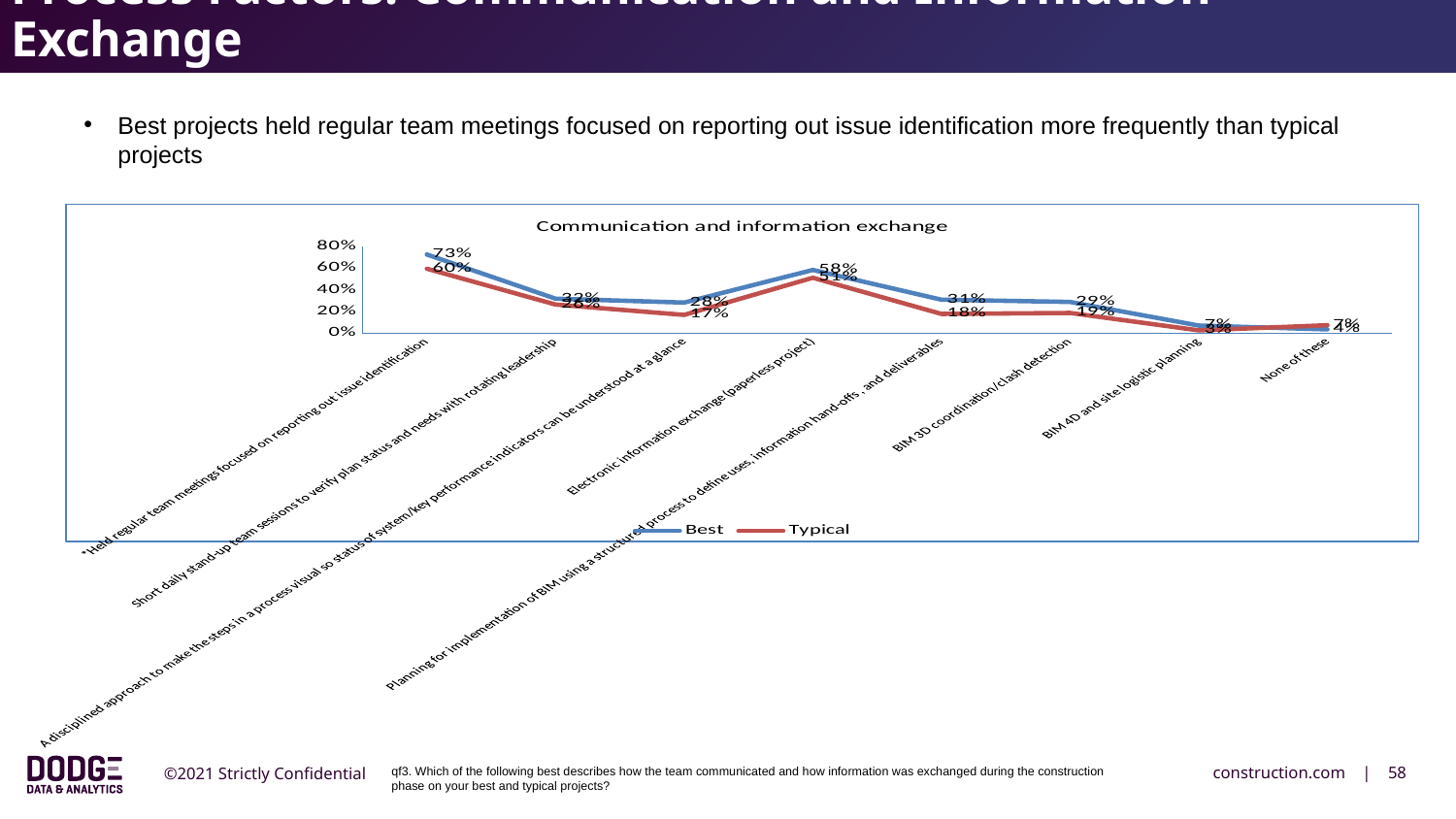
Which is larger for 'Electronic information exchange (paperless project)': the Best value or the Typical value? Best What type of chart is shown on the slide? Line chart Which category has the highest Best value? Held regular team meetings focused on reporting out issue identification What is the Best value for 'Electronic information exchange (paperless project)'? 58% What is the Typical value for 'BIM 3D coordination/clash detection'? 19% How many categories are plotted along the x axis? 8 How many series does the chart legend list? 2 What is the difference between the Best and Typical values for 'Held regular team meetings focused on reporting out issue identification'? 13% What is the title of the chart? Communication and information exchange What is the Typical value for 'Held regular team meetings focused on reporting out issue identification'? 60% What is the Best value for 'Held regular team meetings focused on reporting out issue identification'? 73% What is the difference between the Best and Typical values for 'BIM 3D coordination/clash detection'? 10%